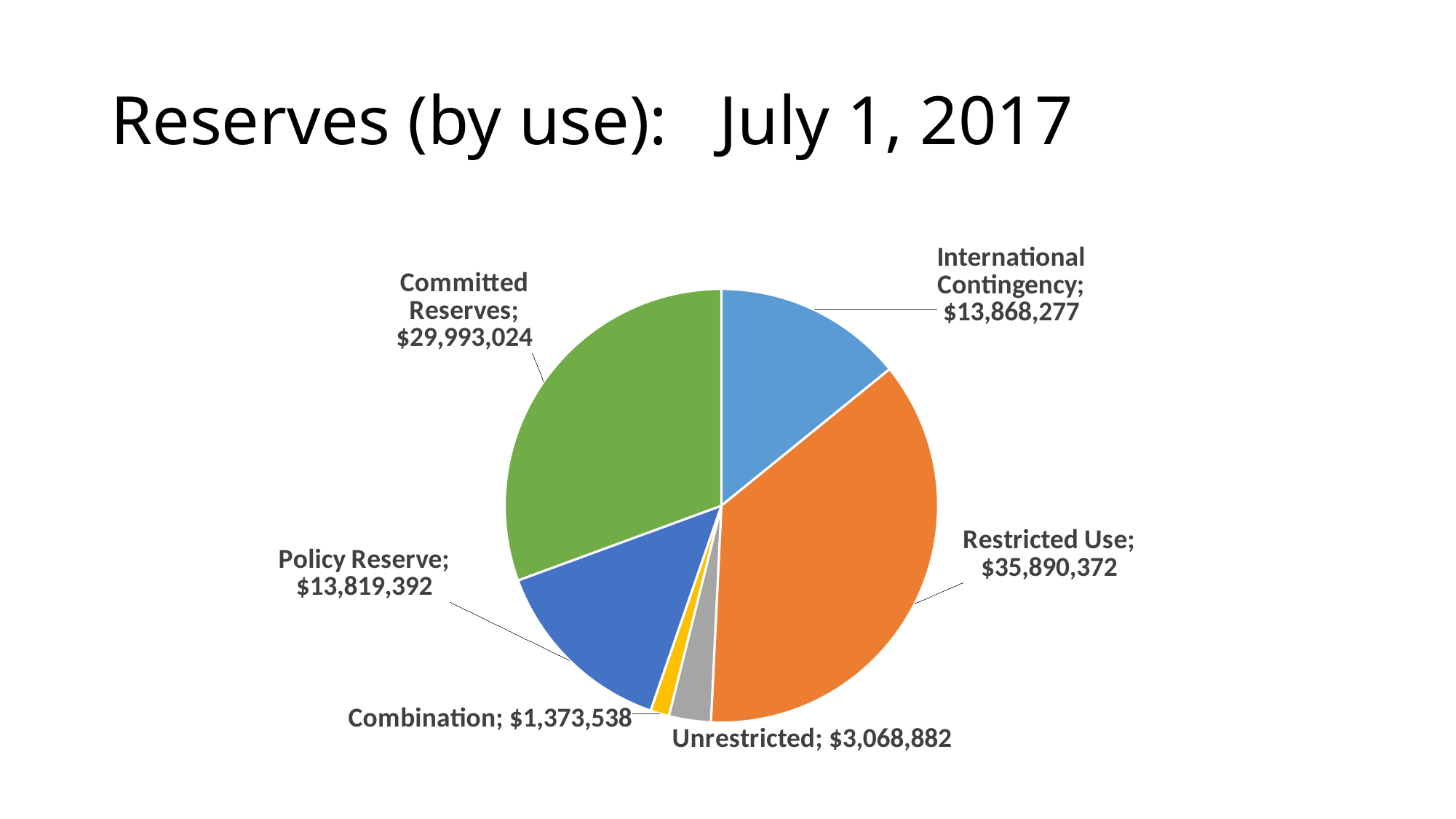
What is the difference between the Restricted Use and Committed Reserves values? $5,897,348 How many categories are shown in the pie chart? 6 What kind of chart is shown on the slide? Pie chart Which is larger, Committed Reserves or Restricted Use? Restricted Use What is the value of the Combination slice? $1,373,538 What is the title of the slide? Reserves (by use): July 1, 2017 Which category has the largest slice of the pie? Restricted Use Which category has the smallest slice of the pie? Combination What is the difference between the Unrestricted and Combination values? $1,695,344 What is the value of the Committed Reserves slice? $29,993,024 What is the value of the Policy Reserve slice? $13,819,392 What is the value of the Restricted Use slice? $35,890,372